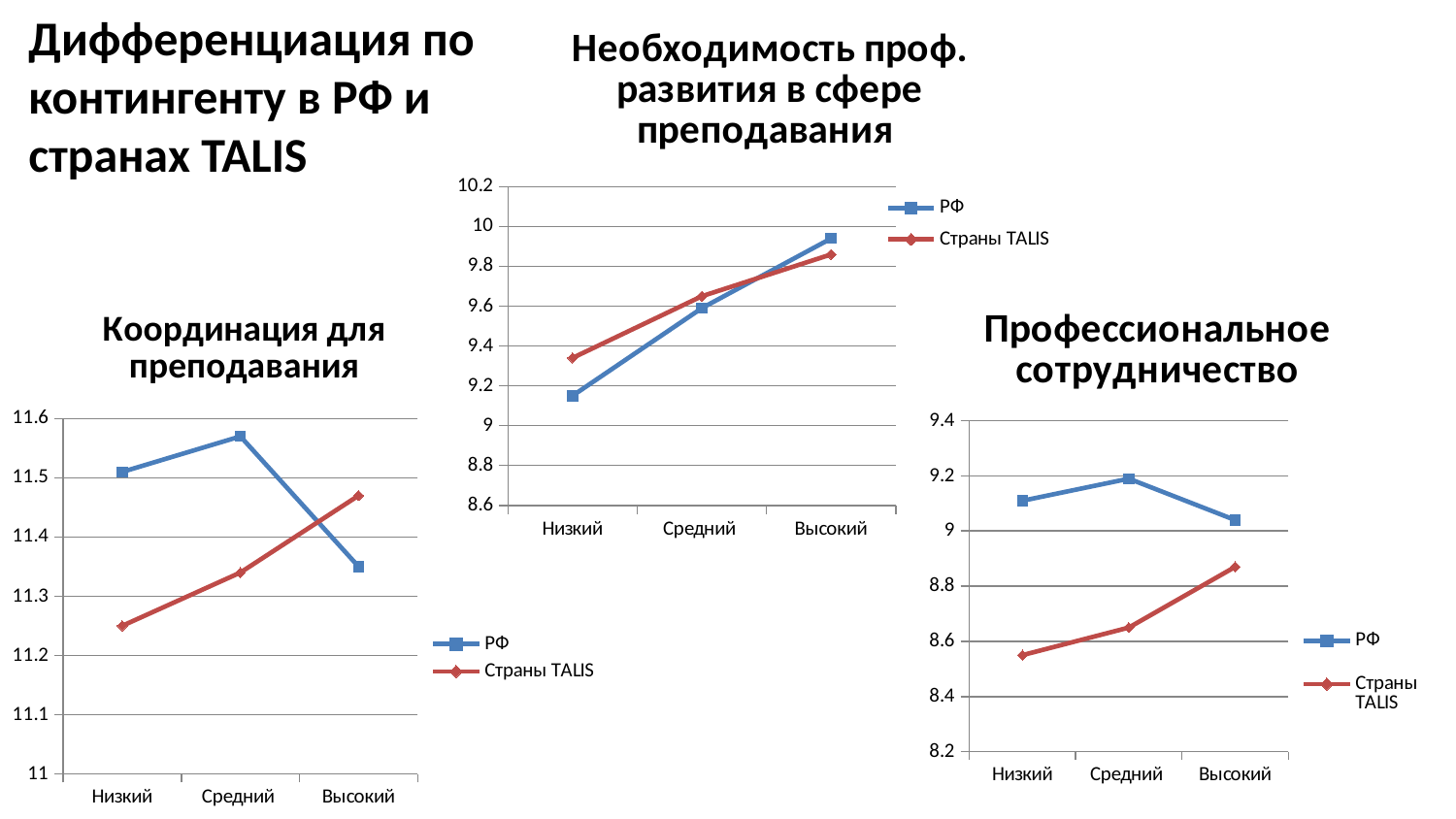
How many series does the legend of the 'Необходимость проф. развития в сфере преподавания' chart list? 2 In the 'Координация для преподавания' chart, is the value for Страны TALIS at Низкий greater or less than 11.3? less How many categories are shown on the x axis of the 'Профессиональное сотрудничество' chart? 3 In the 'Необходимость проф. развития в сфере преподавания' chart, do the values for Страны TALIS rise or fall from Низкий to Высокий? rise In the 'Профессиональное сотрудничество' chart, at which category is the РФ series highest? Средний In the 'Координация для преподавания' chart, which series has the larger value at Высокий, РФ or Страны TALIS? Страны TALIS In the 'Необходимость проф. развития в сфере преподавания' chart, is the value for РФ at Высокий greater or less than 9.8? greater In the 'Необходимость проф. развития в сфере преподавания' chart, which series has the larger value at Низкий, РФ or Страны TALIS? Страны TALIS In the 'Профессиональное сотрудничество' chart, at which category is the Страны TALIS series lowest? Низкий In the 'Профессиональное сотрудничество' chart, is the value for Страны TALIS at Высокий greater or less than 8.8? greater What type of chart is the 'Координация для преподавания' chart? line chart